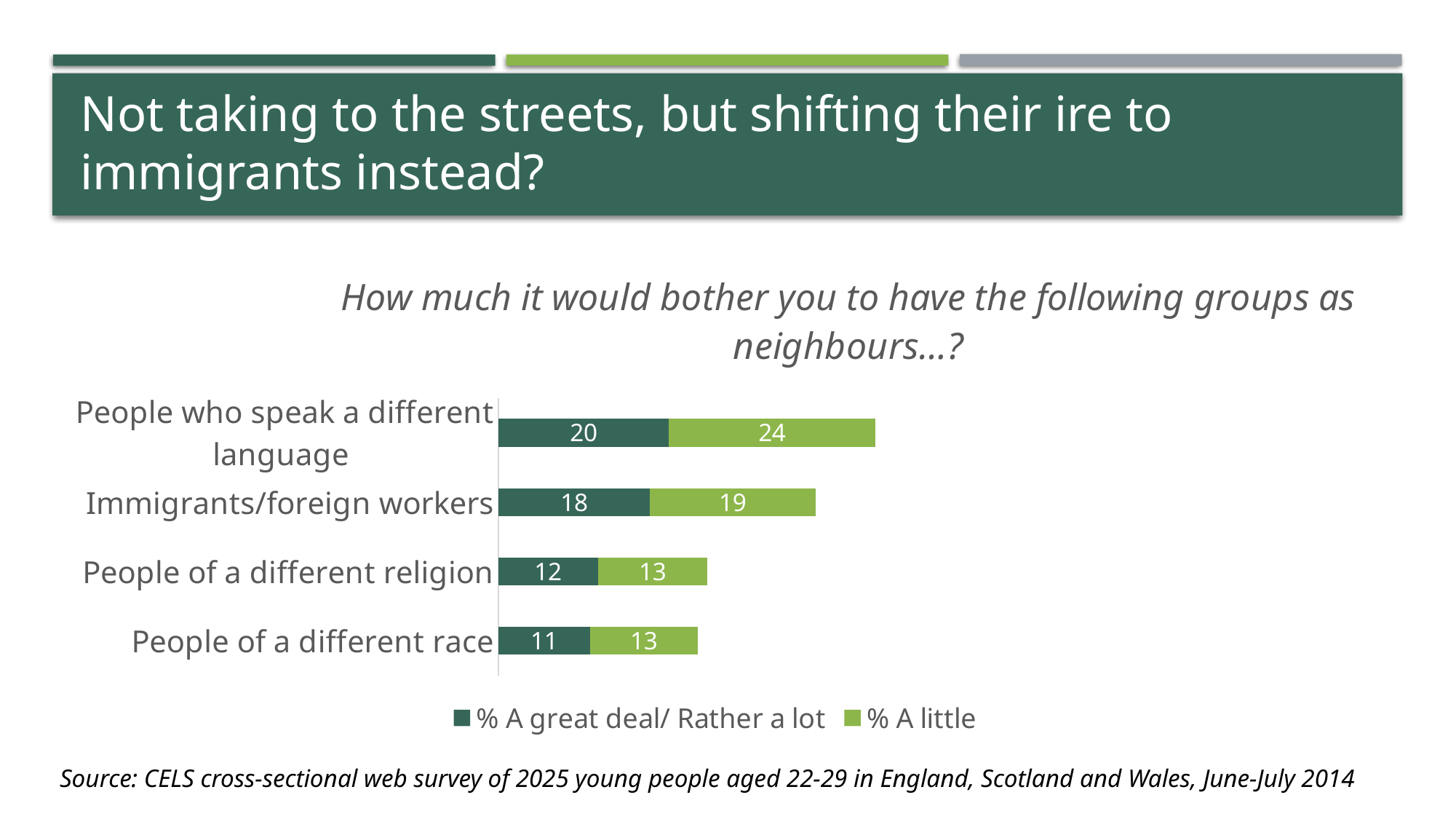
How many series does the legend list? 2 What is the title of the chart? How much it would bother you to have the following groups as neighbours...? Which category has the highest value for '% A little'? People who speak a different language What kind of chart is shown on the slide? Stacked bar chart Which is larger: the '% A great deal/ Rather a lot' value for Immigrants/foreign workers or for People of a different religion? Immigrants/foreign workers What is the value for '% A little' for Immigrants/foreign workers? 19 What is the difference between the '% A little' values for People who speak a different language and Immigrants/foreign workers? 5 What is the value for '% A great deal/ Rather a lot' for People who speak a different language? 20 Which category has the lowest value for '% A great deal/ Rather a lot'? People of a different race How many categories are shown in the chart? 4 What is the total of the stacked bar for People of a different religion? 25 What is the value for '% A great deal/ Rather a lot' for People of a different race? 11